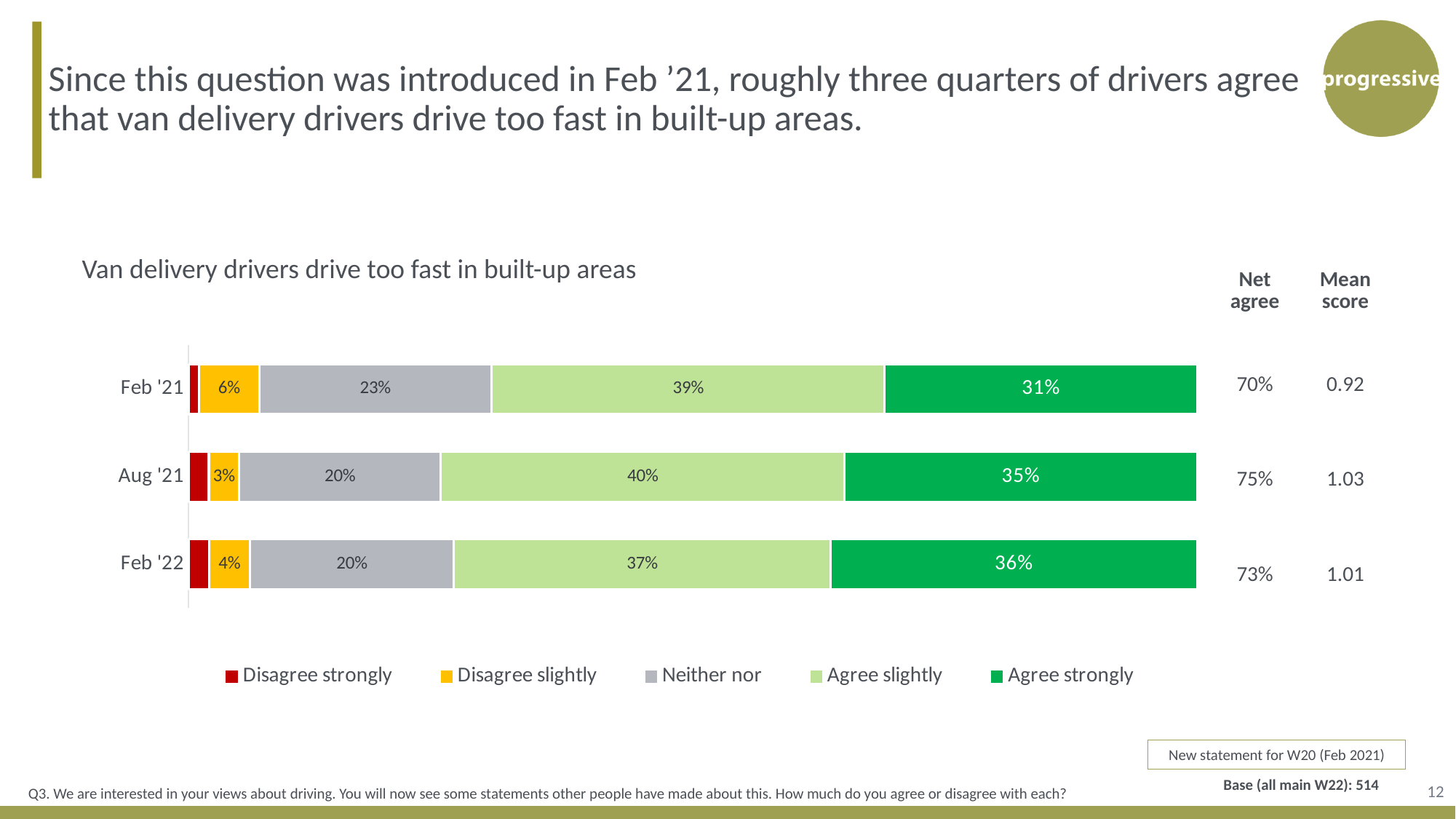
What is the difference between the 'Agree strongly' values for Aug '21 and Feb '21? 4 percentage points What is the 'Agree slightly' value for Aug '21? 40% What is the Net agree figure shown for Aug '21? 75% Which period has the highest 'Agree strongly' value? Feb '22 What percentage of drivers agreed strongly in Feb '22? 36% What is the 'Neither nor' value for Feb '21? 23% What kind of chart is shown on the slide? Stacked bar chart Which is larger: the 'Disagree slightly' value for Feb '21 or for Feb '22? Feb '21 Which period has the lowest 'Agree slightly' value? Feb '22 How many time periods (categories) are plotted in the chart? 3 How many series does the legend list? 5 What is the 'Disagree slightly' value for Aug '21? 3%